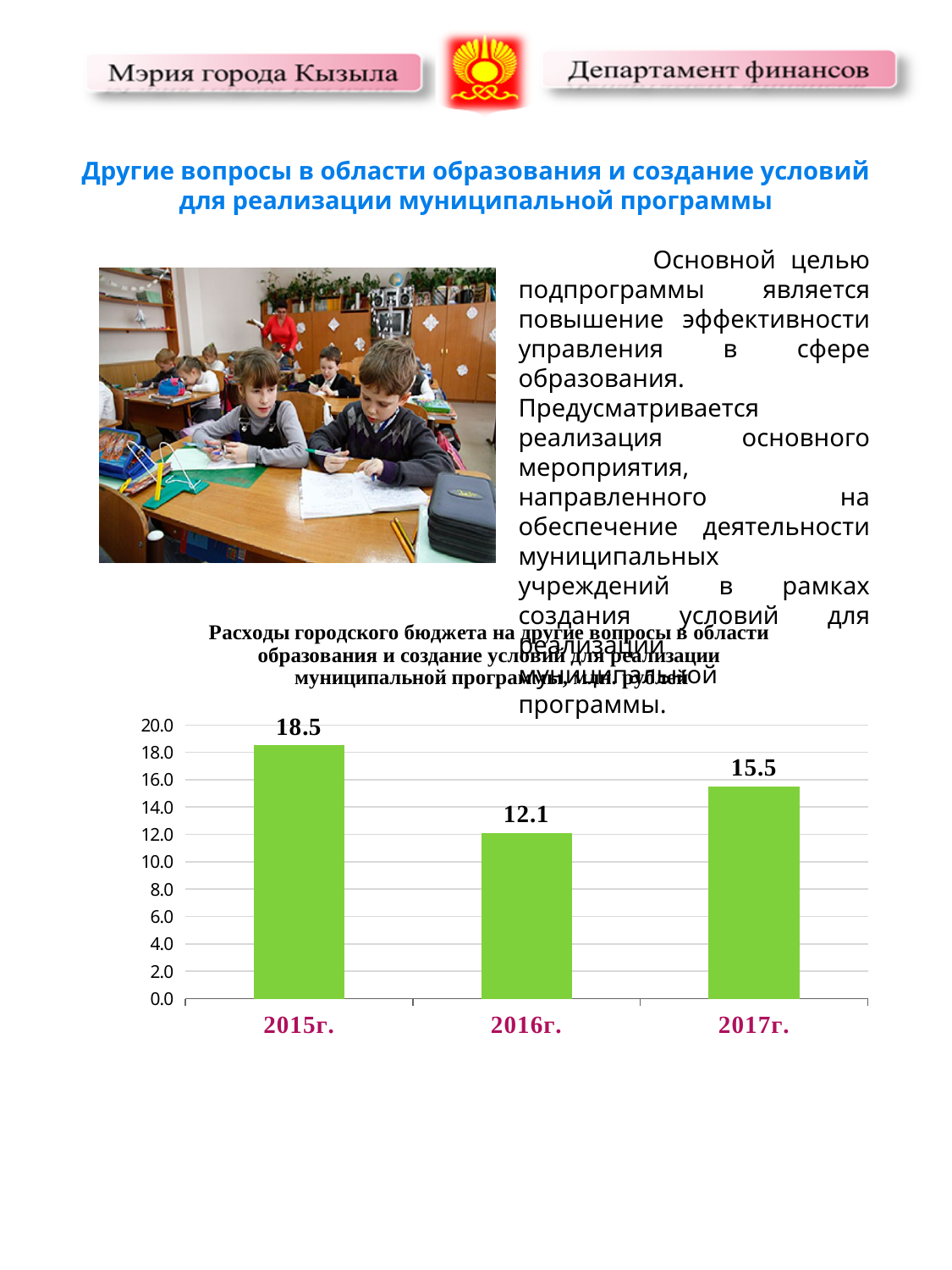
What is the difference between the values for 2015г. and 2016г.? 6.4 Which is larger, the value for 2015г. or the value for 2017г.? 2015г. What is the value for 2016г.? 12.1 What is the difference between the values for 2017г. and 2016г.? 3.4 What is the value for 2017г.? 15.5 Which year has the highest value? 2015г. What is the value for 2015г.? 18.5 What colour are the bars in the chart? green What kind of chart is shown on the slide? bar chart Is the value for 2016г. greater or less than 14.0? less How many years are shown on the chart? 3 Which year has the lowest value? 2016г.